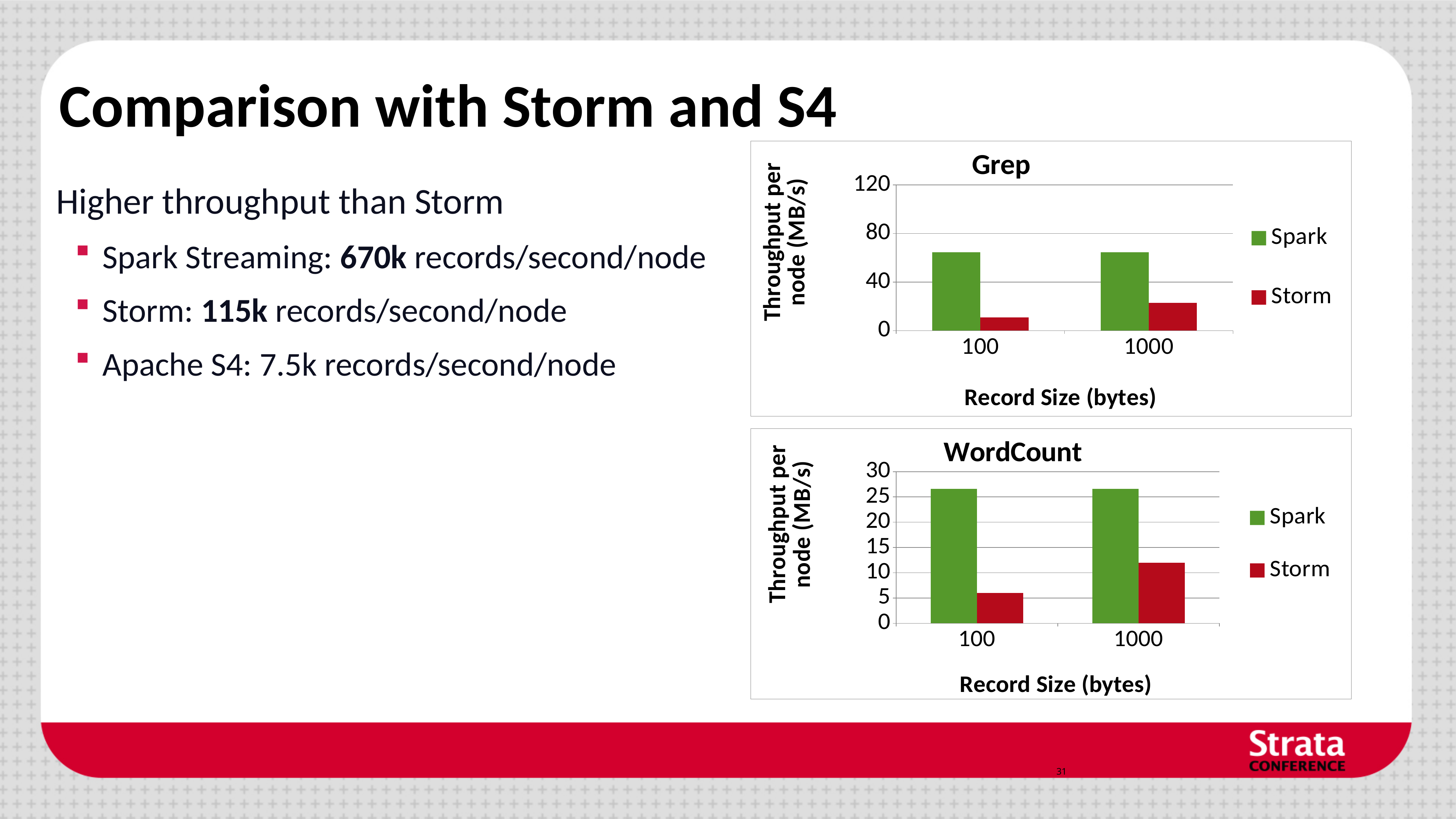
In the Grep chart, is the Storm value at record size 100 greater or less than 40? less In the WordCount chart, is the Spark value at record size 100 greater or less than 20? greater In the WordCount chart, which series has the higher value at record size 1000, Spark or Storm? Spark What is the x-axis title of the WordCount chart? Record Size (bytes) In the WordCount chart, is the Storm value at record size 1000 greater or less than 15? less How many series does the legend of the WordCount chart list? 2 What kind of chart is the Grep chart? bar chart How many record size categories are shown on the x axis of the Grep chart? 2 In the Grep chart, which is larger for Storm: the value at record size 100 or at record size 1000? 1000